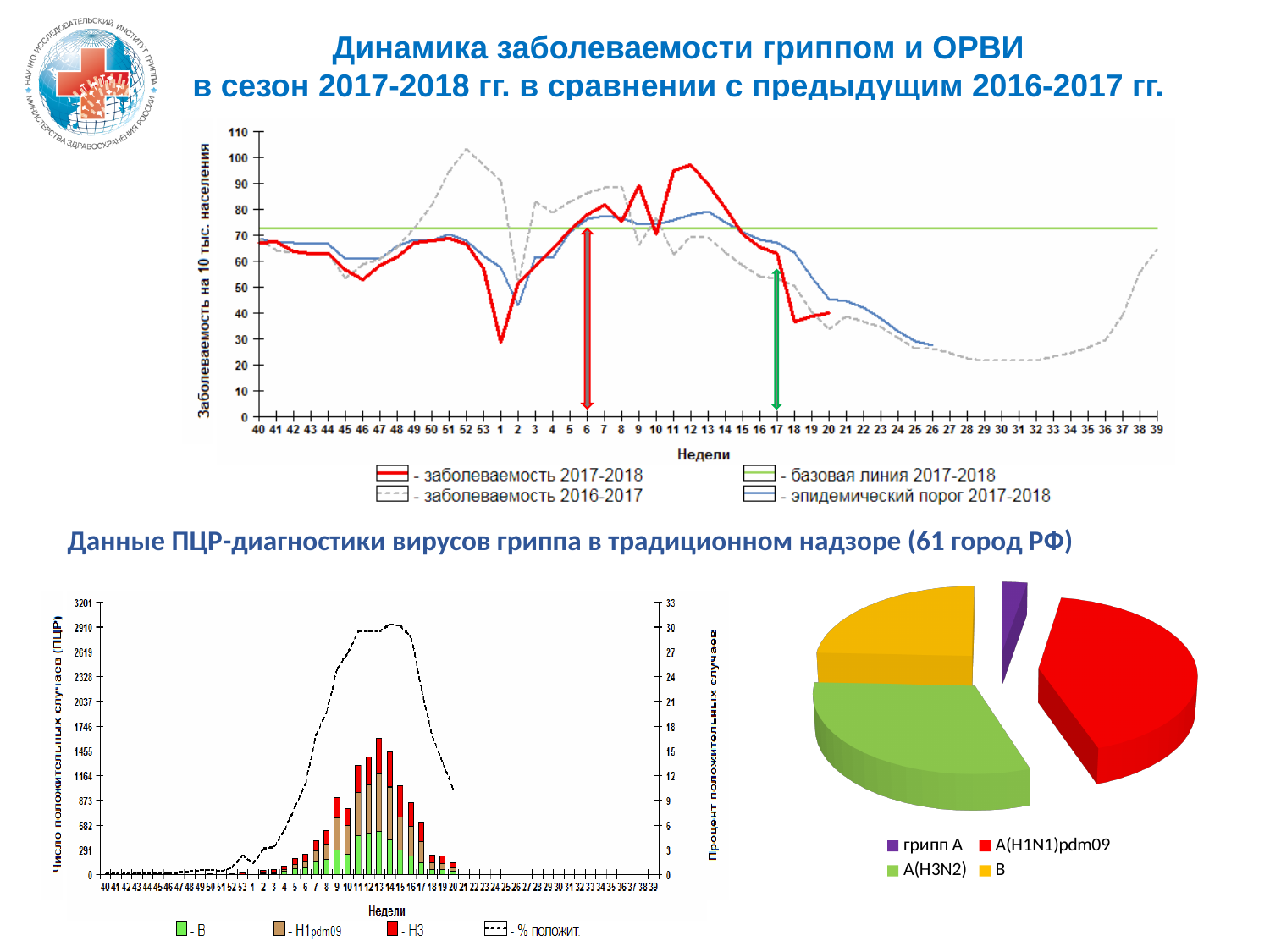
In the top line chart, which series is drawn as a grey dashed line? заболеваемость 2016-2017 In the bottom-right pie chart, which category has the smallest slice? грипп А In the top line chart, is the 2017-2018 incidence value at week 1 greater or less than 40? less How many entries does the legend of the bottom-left bar chart list? 4 In the top line chart, is the 2017-2018 baseline (базовая линия) greater or less than 70? greater How many series does the legend of the top line chart list? 4 What kind of chart is the top chart titled 'Динамика заболеваемости гриппом и ОРВИ'? line chart In the top line chart, is the 2016-2017 incidence value at week 52 greater or less than 90? greater What kind of chart is the bottom-left chart showing the number of positive PCR cases? bar chart How many slices does the bottom-right pie chart have? 4